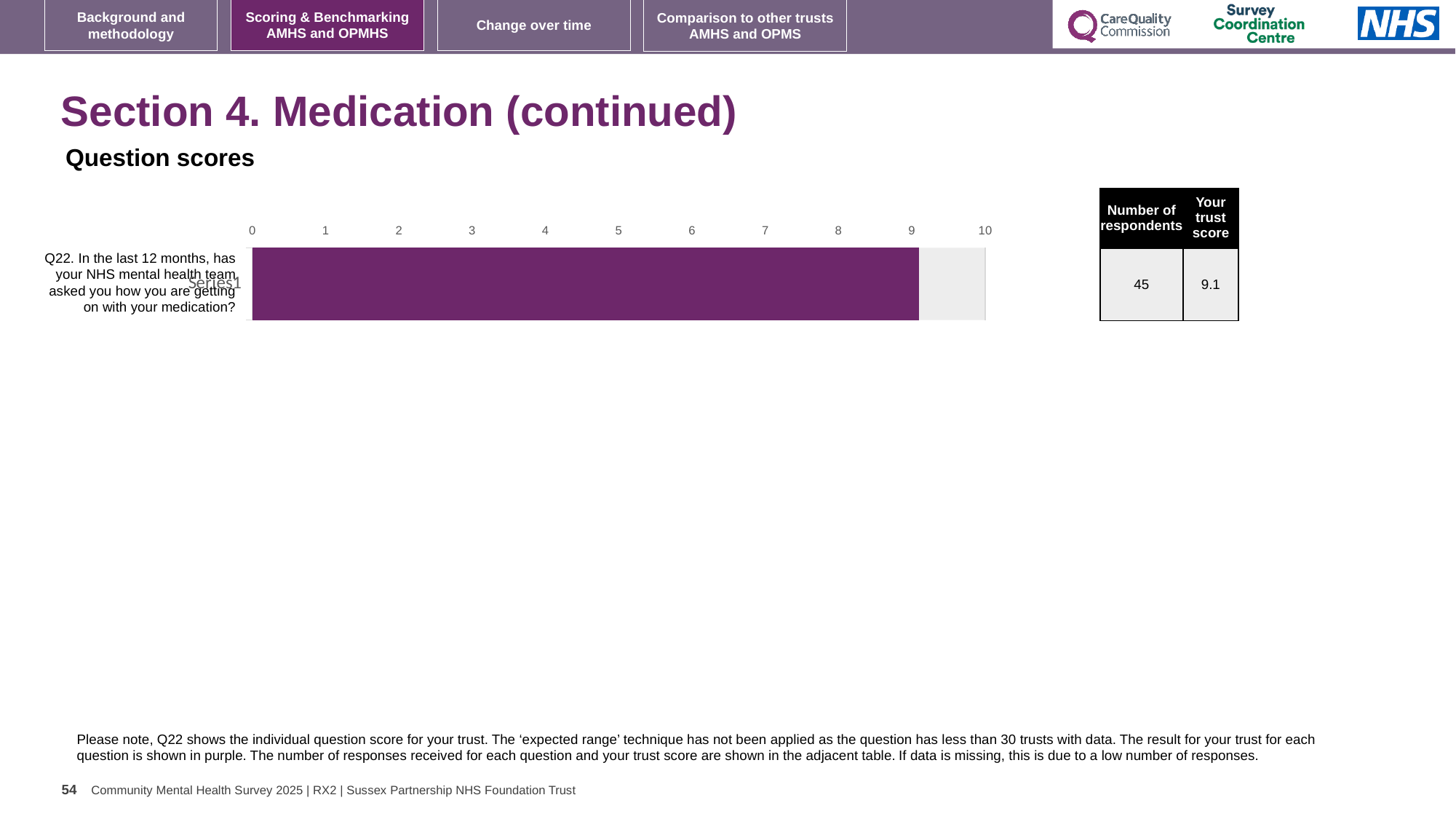
Is the bar for Q22 greater or less than 9 on the axis? greater Is the bar for Q22 greater or less than 5 on the axis? greater According to the adjacent table, how many respondents answered Q22? 45 According to the adjacent table, what is the trust score for Q22? 9.1 What kind of chart is shown on the slide? bar chart Is the bar for Q22 greater or less than 10 on the axis? less What is the question number of the item plotted in the chart? Q22 What is the maximum value shown on the chart's horizontal axis? 10 What colour is the bar showing the trust's result for Q22? purple How many questions (categories) are plotted in the bar chart? 1